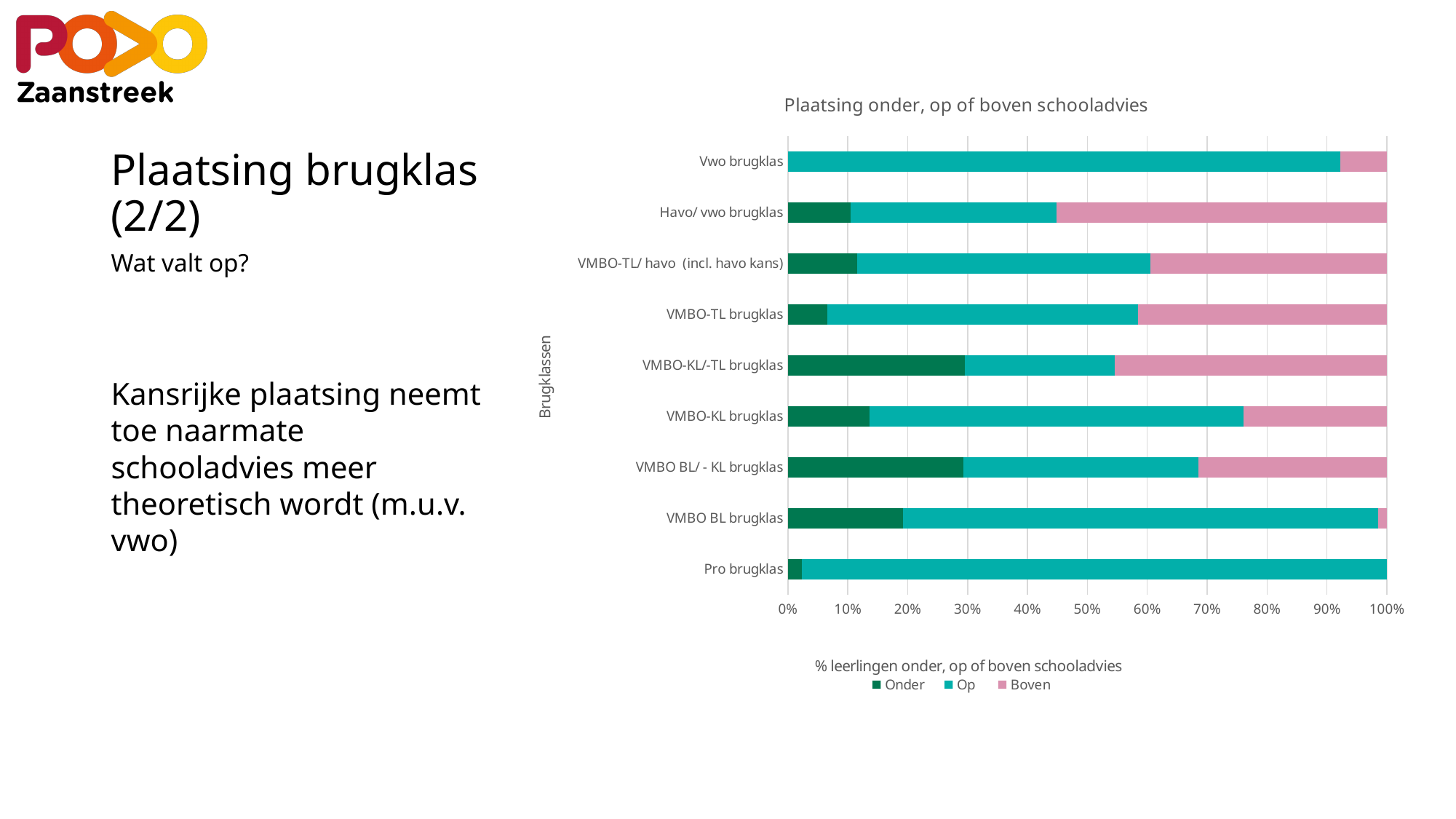
Which brugklas has the largest 'Op' share? Pro brugklas How many series does the chart legend list? 3 Is the 'Op' share for Vwo brugklas greater or less than 90%? greater How many brugklas categories are plotted on the y axis of the chart? 9 Which has the larger 'Onder' share: VMBO-KL/-TL brugklas or VMBO-KL brugklas? VMBO-KL/-TL brugklas Which brugklas has the largest 'Boven' share? Havo/ vwo brugklas Which has the larger 'Boven' share: Vwo brugklas or Havo/ vwo brugklas? Havo/ vwo brugklas Is the 'Onder' share for VMBO-KL/-TL brugklas greater or less than 20%? greater What are the three legend entries of the chart? Onder, Op, Boven What kind of chart is shown on the slide? Stacked bar chart Is the 'Onder' share for Pro brugklas greater or less than 10%? less What is the title of the chart? Plaatsing onder, op of boven schooladvies